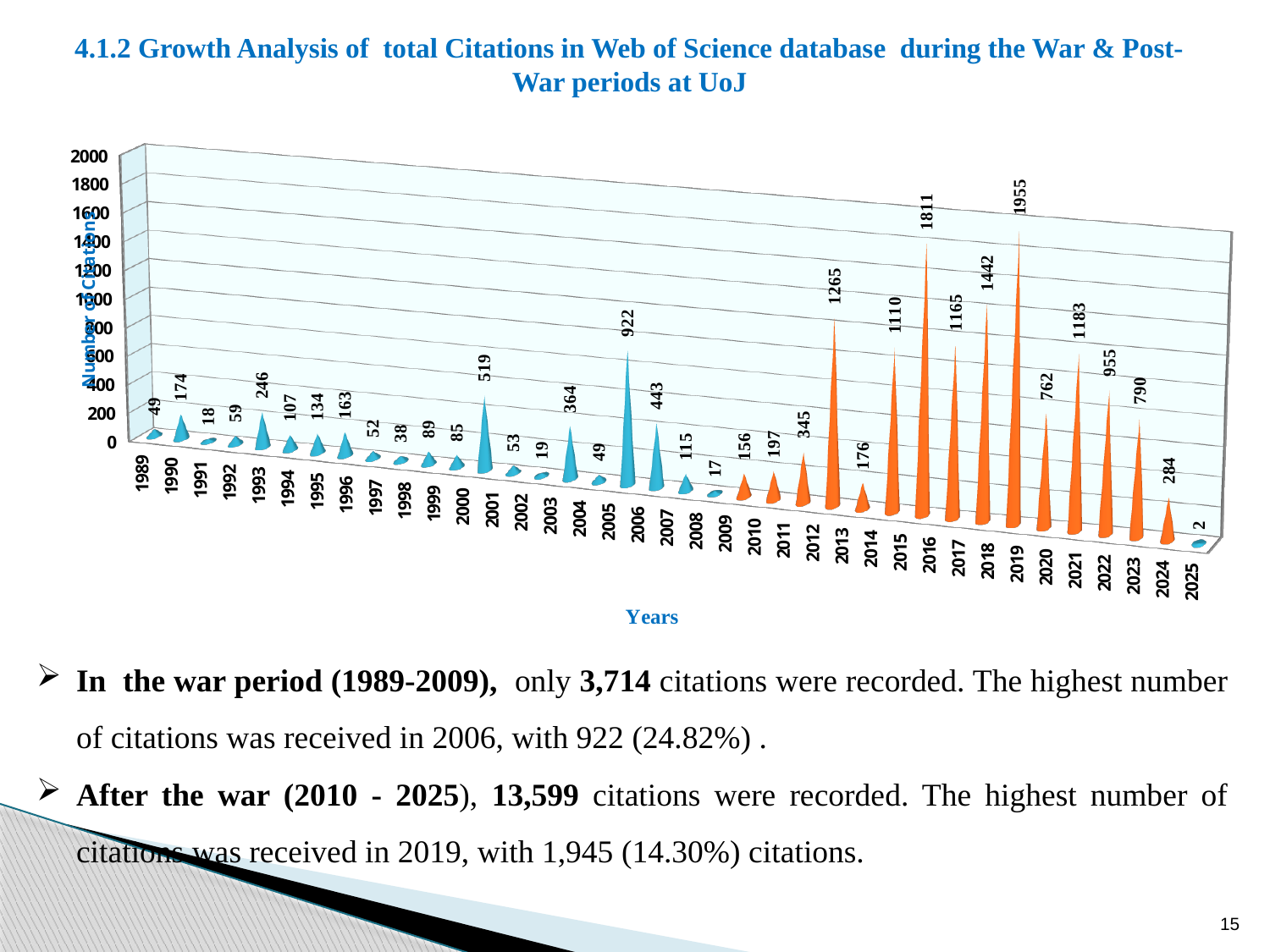
Which year has the highest number of citations? 2019 What value is labelled for the year 2013? 1265 What is the highest tick value shown on the y axis? 2000 Is the value for 2021 greater or less than 1000? greater What is the label of the x axis? Years Which year had more citations, 2001 or 2007? 2001 What kind of chart is shown on the slide? bar chart Which year has the lowest number of citations? 2025 How many years are plotted on the x axis? 37 How many citations were recorded in 2006? 922 What is the number of citations shown for 2016? 1811 What is the difference between the citations in 2019 and 2018? 513